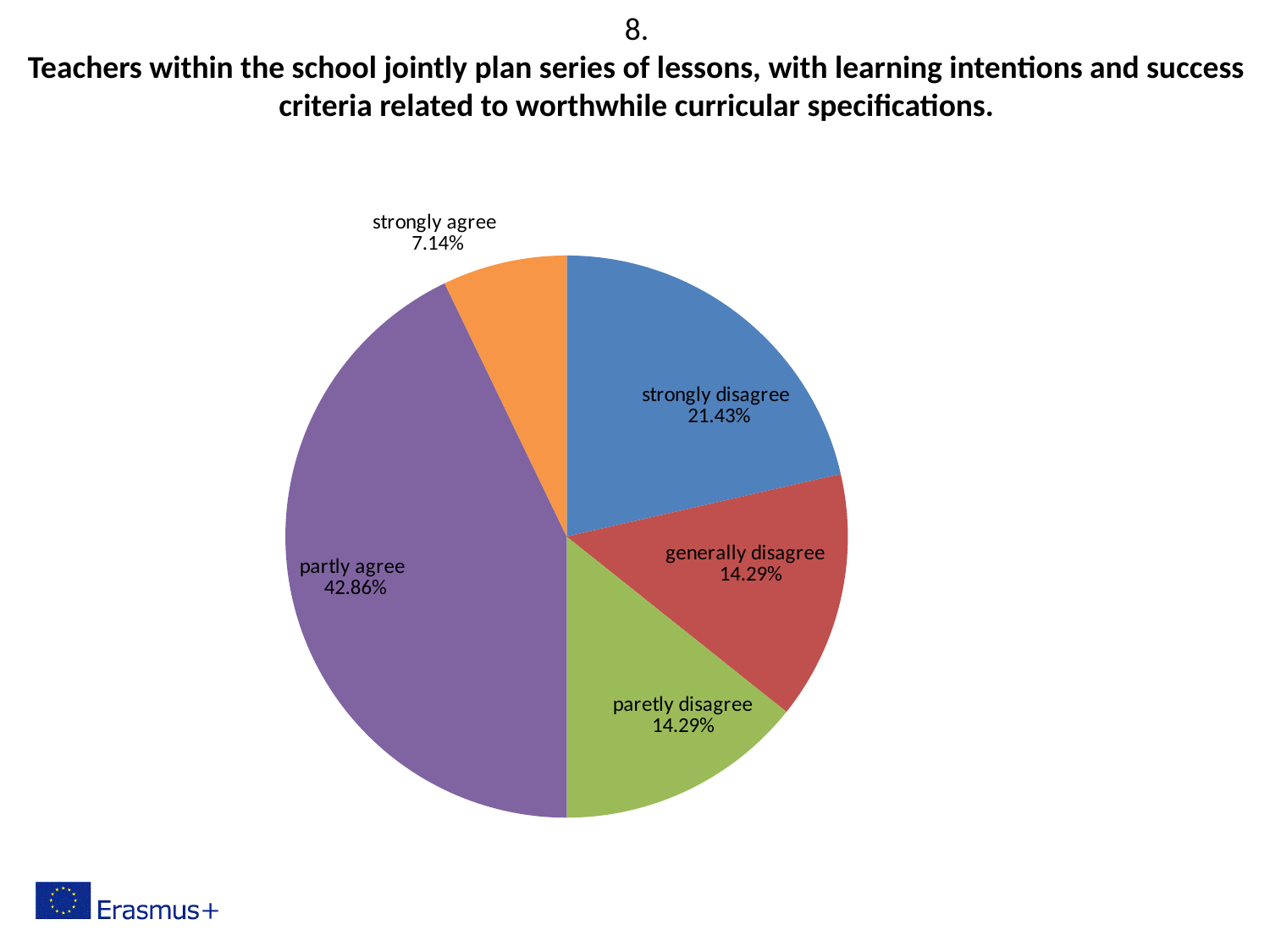
What share of the pie is labelled "generally disagree"? 14.29% What share of the pie is labelled "strongly agree"? 7.14% What share of the pie is labelled "partly agree"? 42.86% What colour is the "partly agree" slice? purple What share of the pie is labelled "strongly disagree"? 21.43% What kind of chart is shown on the slide? pie chart Which category has the largest slice of the pie? partly agree Which is larger, the share for "strongly disagree" or the share for "paretly disagree"? strongly disagree How many slices does the pie chart have? 5 What is the combined share of "generally disagree" and "paretly disagree"? 28.58% What is the difference in percentage points between "partly agree" and "strongly disagree"? 21.43 Which category has the smallest slice of the pie? strongly agree